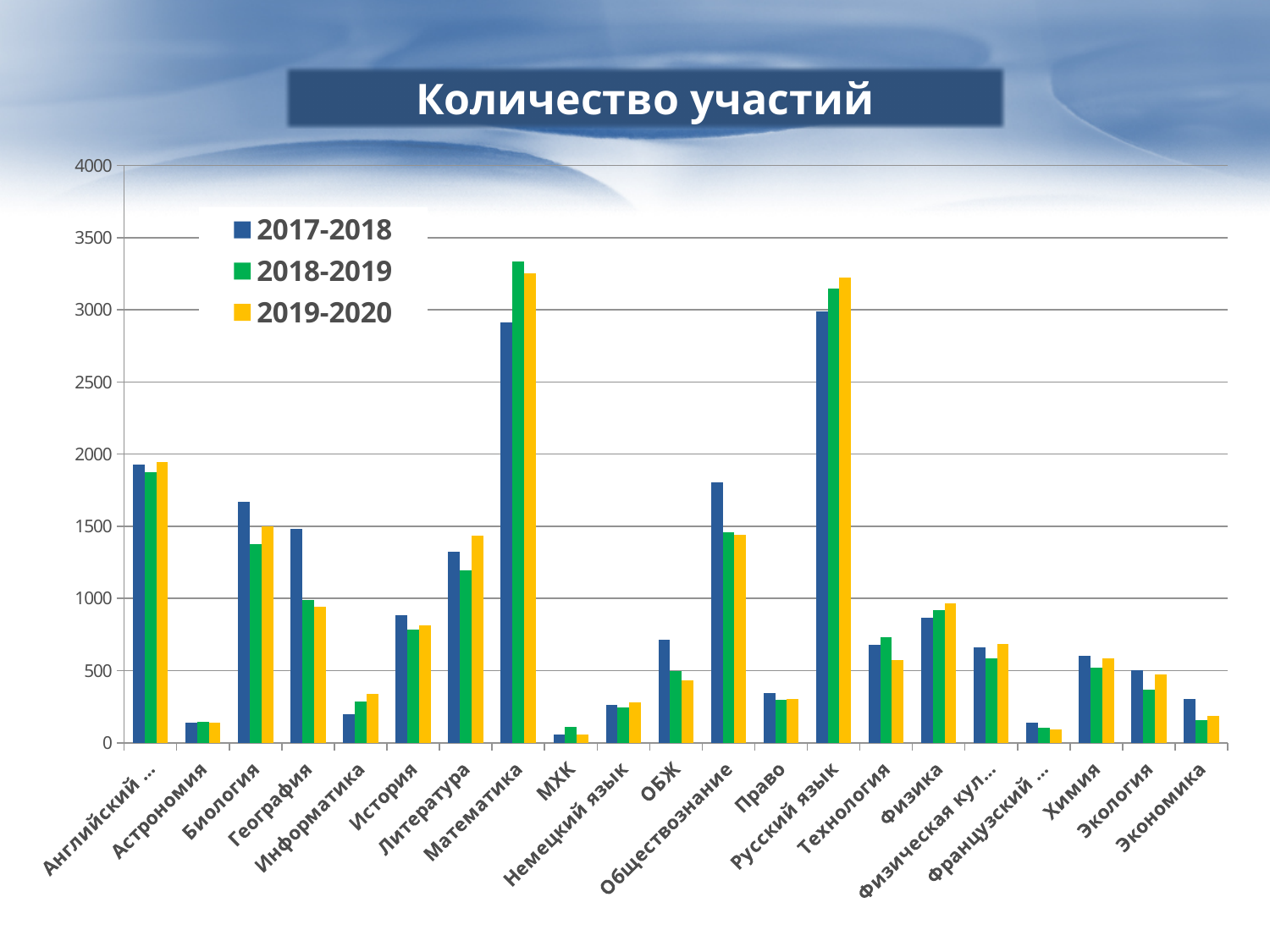
Is the value for Математика in 2017-2018 greater or less than 3000? less Which category has the lowest bars in the chart? МХК How many series does the legend list? 3 Is the value for Обществознание in 2017-2018 greater or less than 1500? greater For Биология, which is larger: the value for 2017-2018 or for 2018-2019? 2017-2018 Is the value for Русский язык in 2019-2020 greater or less than 3000? greater What is the title of the chart? Количество участий For Литература, which is larger: the value for 2017-2018 or for 2019-2020? 2019-2020 Which category has the highest bar in the chart? Математика How many categories are shown on the x axis? 21 What kind of chart is shown on the slide? bar chart